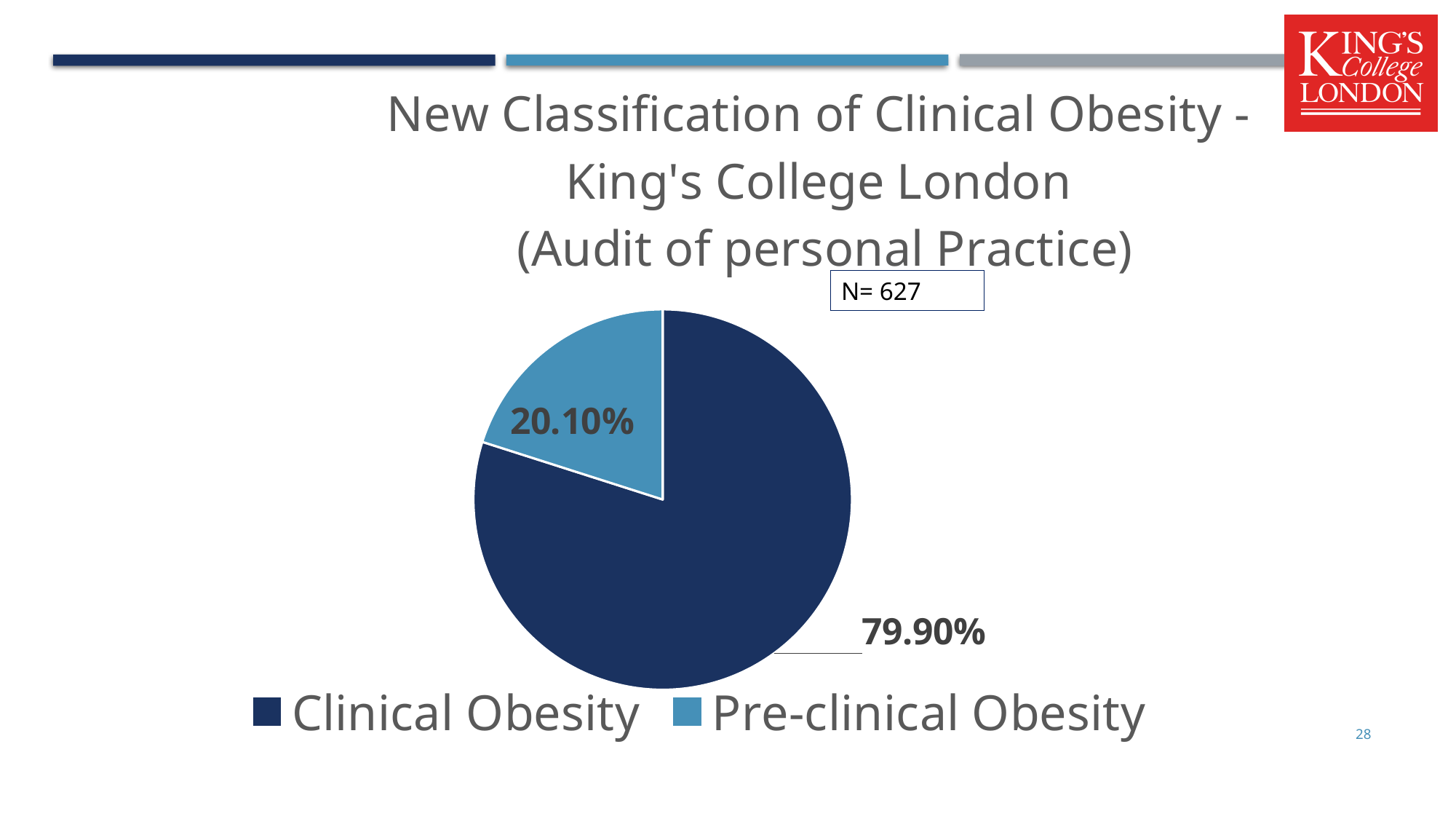
What type of chart is shown on the slide? pie chart What percentage of the pie is Pre-clinical Obesity? 20.10% Which category has the smallest share of the pie? Pre-clinical Obesity What is the difference in percentage points between Clinical Obesity and Pre-clinical Obesity? 59.80% Which colour represents Pre-clinical Obesity in the pie chart? light blue What is the sample size (N) shown on the slide? 627 How many entries does the legend list? 2 Which category has the largest share of the pie? Clinical Obesity Which is larger, the share for Clinical Obesity or the share for Pre-clinical Obesity? Clinical Obesity What percentage of the pie is Clinical Obesity? 79.90% How many slices does the pie chart have? 2